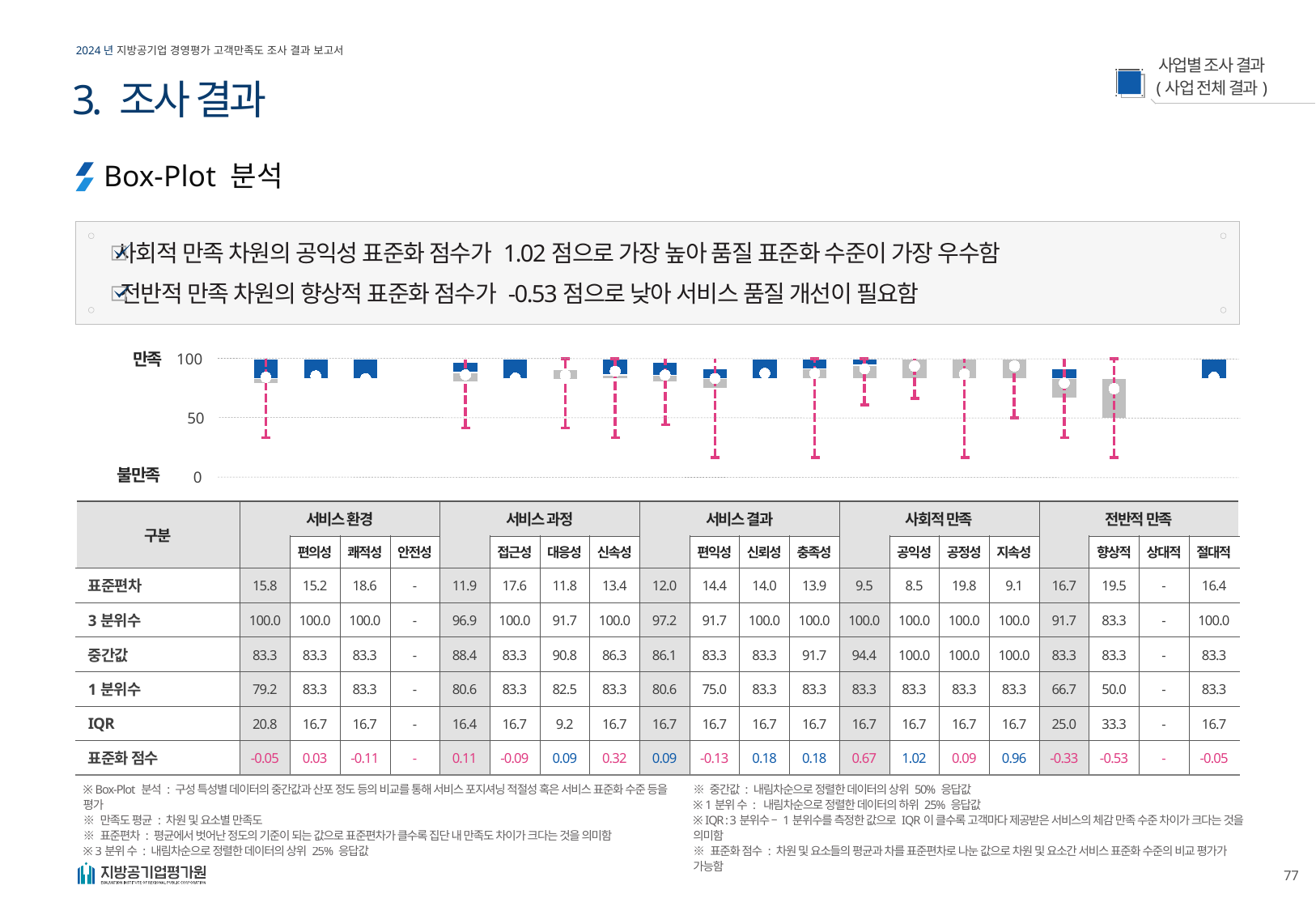
What is the 1 분위수 for 향상적? 50.0 Which has the larger 표준화 점수, 신속성 or 대응성? 신속성 What is the 표준편차 for 공정성 under 사회적 만족? 19.8 What kind of chart is shown on the slide? Box plot What is the IQR for 향상적 under 전반적 만족? 33.3 What is the difference between the 3 분위수 and the 1 분위수 for 향상적? 33.3 What is the 중간값 for 편의성 under 서비스 환경? 83.3 How many dimensions (차원) are shown in the table header? 5 What are the labels at the top and bottom of the chart's y axis? 만족 and 불만족 What is the 중간값 for the 사회적 만족 dimension overall? 94.4 Which item has the lowest 표준화 점수 in the table? 향상적 (-0.53) Which item has the highest 표준화 점수 in the table? 공익성 (1.02)